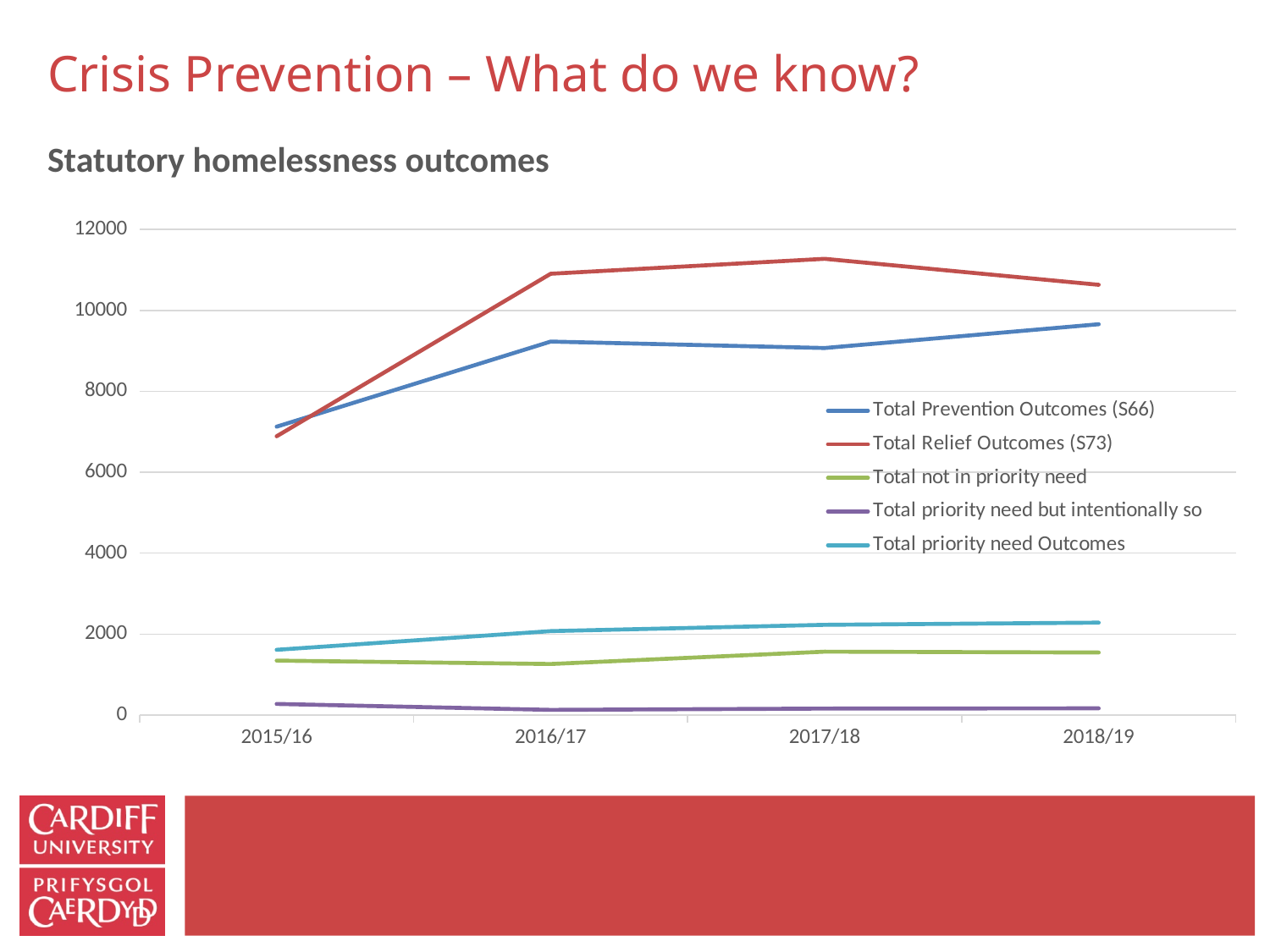
How many years are shown on the x axis? 4 Is the value for Total Relief Outcomes (S73) in 2017/18 greater or less than 10000? greater Which series has the highest value in 2016/17? Total Relief Outcomes (S73) Is the value for Total priority need Outcomes in 2018/19 greater or less than 2000? greater In which year is Total Relief Outcomes (S73) highest? 2017/18 How many series does the legend list? 5 What is the title of the chart? Statutory homelessness outcomes What kind of chart is shown on the slide? line chart In which year is Total Relief Outcomes (S73) lowest? 2015/16 Is the value for Total Prevention Outcomes (S66) in 2015/16 greater or less than 8000? less In 2018/19, which is larger: Total Relief Outcomes (S73) or Total Prevention Outcomes (S66)? Total Relief Outcomes (S73) Which series has the lowest value in 2018/19? Total priority need but intentionally so